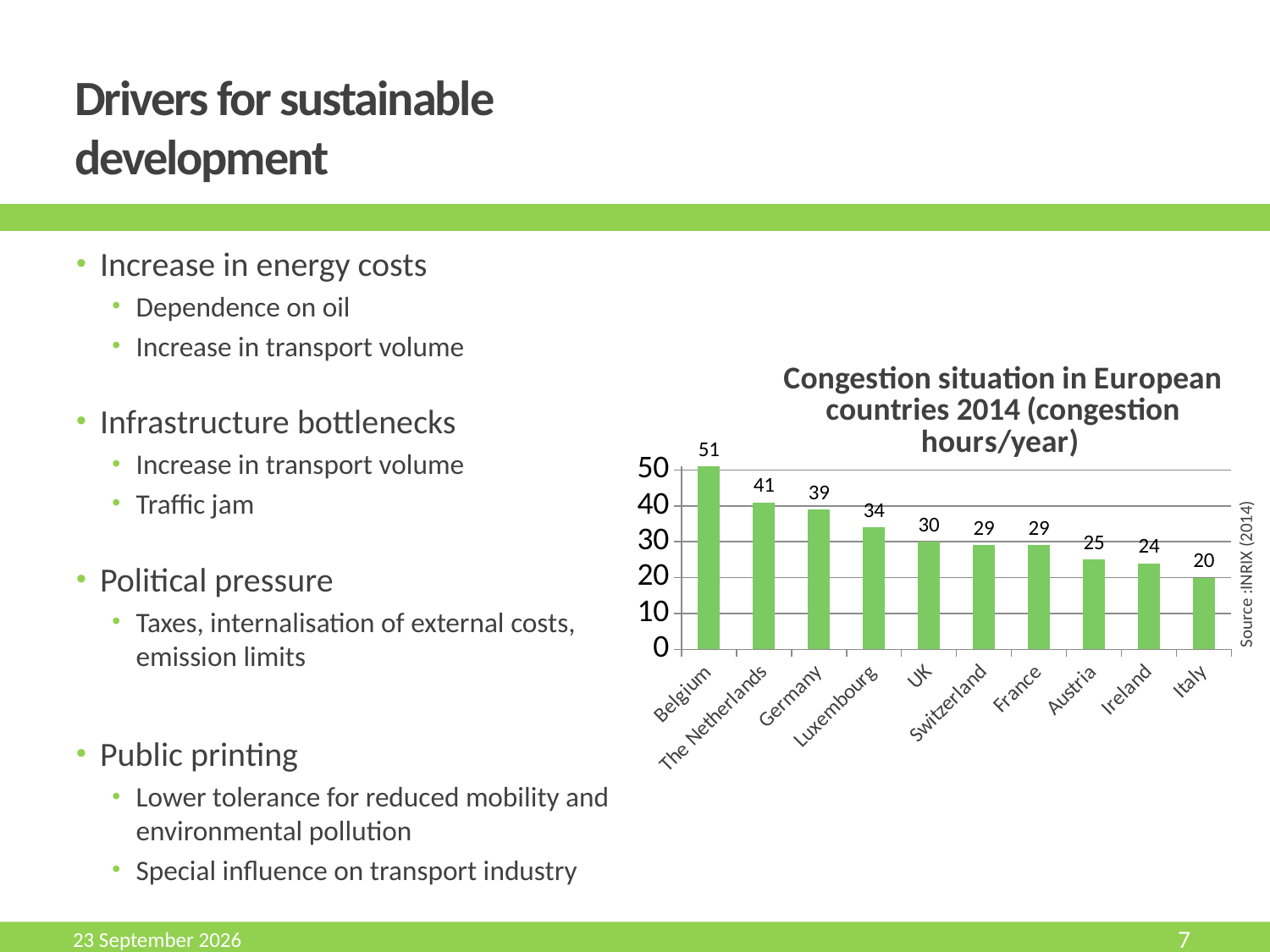
How many countries are shown in the chart? 10 Which has more congestion hours, Germany or the UK? Germany Which country has the highest congestion hours per year? Belgium What is the congestion value for Ireland? 24 Which country has the lowest congestion hours per year? Italy Do the values rise or fall from left to right across the countries? Fall What is the difference in congestion hours between Belgium and Italy? 31 What is the title of the chart? Congestion situation in European countries 2014 (congestion hours/year) What is the congestion value for Belgium? 51 What is the congestion value for Luxembourg? 34 What type of chart is shown on the slide? Bar chart What is the difference in congestion hours between The Netherlands and Germany? 2